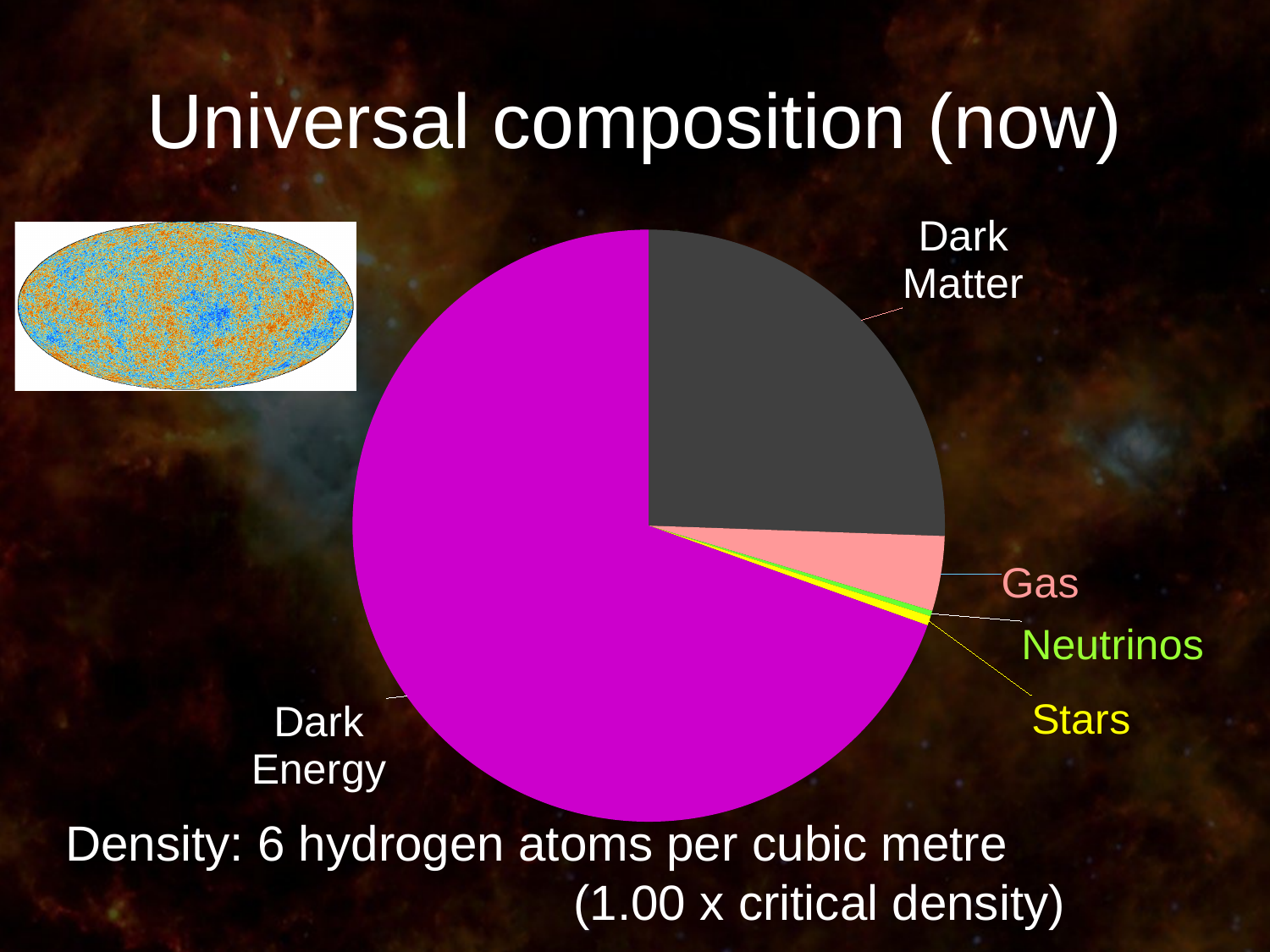
Which slice of the pie chart is coloured yellow? Stars Which is larger in the pie chart, Dark Energy or Dark Matter? Dark Energy What kind of chart is shown on the slide? pie chart What colour is the Dark Energy slice in the pie chart? magenta How many slices does the pie chart have? 5 What is the title of the slide containing the pie chart? Universal composition (now) Does the Dark Energy slice take up more or less than half of the pie? more Does the Dark Matter slice take up more or less than half of the pie? less Which component has the largest slice of the pie chart? Dark Energy Which is larger in the pie chart, Dark Matter or Gas? Dark Matter Which is larger in the pie chart, Gas or Stars? Gas